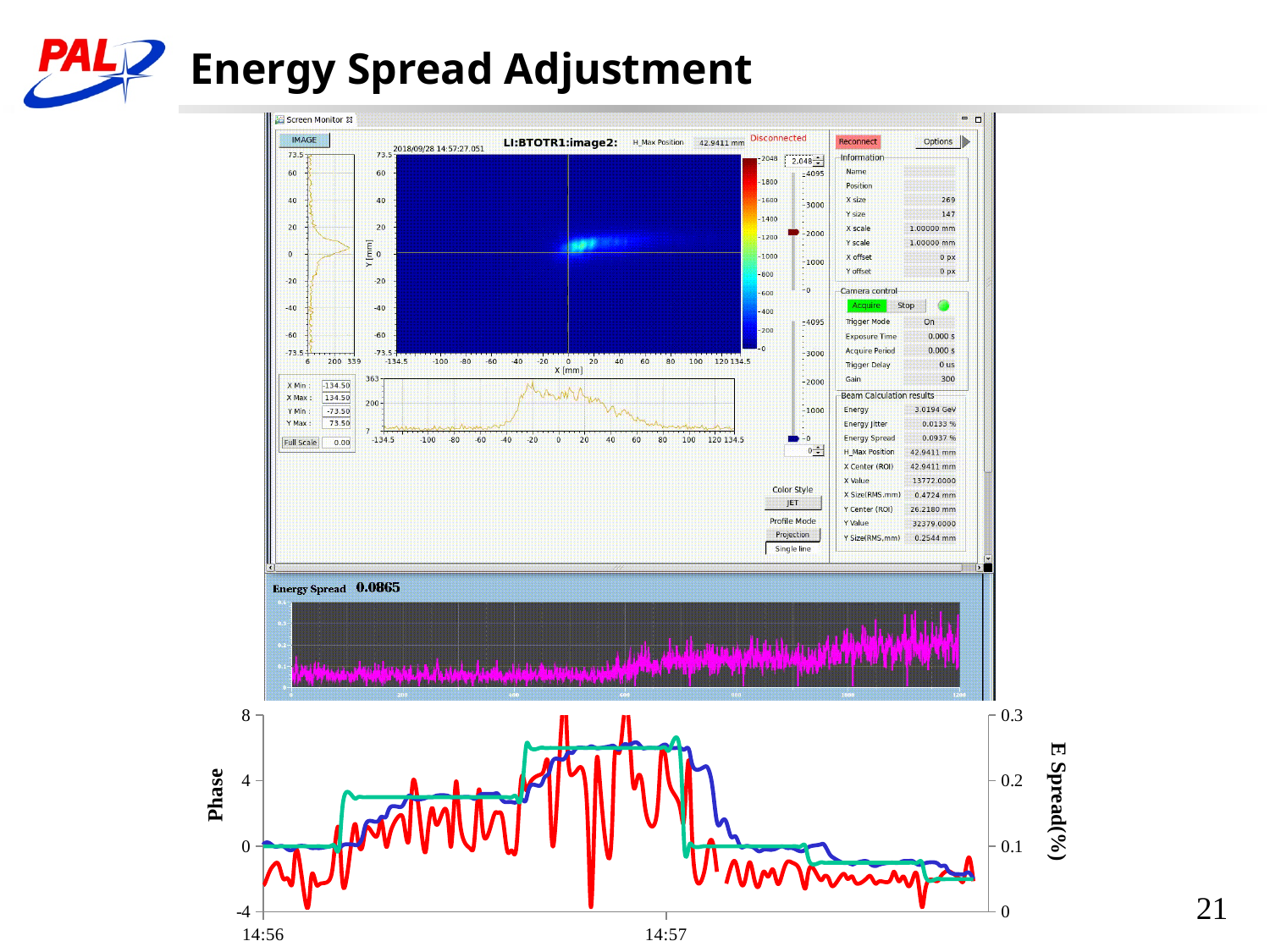
How many lines are plotted in the bottom chart? 3 In the bottom chart, what is the lowest tick value shown on the left Phase axis? -4 In the bottom chart, at 14:56 is the green line greater or less than 2 on the Phase axis? less In the bottom chart, what is the highest tick value shown on the right E Spread(%) axis? 0.3 What kind of chart is the chart at the bottom of the slide? line chart In the bottom chart, what is the highest tick value shown on the left Phase axis? 8 In the bottom chart, does the green line rise or fall between 14:56 and the middle of the chart? rise In the bottom chart, what is the label of the left vertical axis? Phase In the bottom chart, what is the label of the right vertical axis? E Spread(%) In the bottom chart, what are the two time labels shown on the x axis? 14:56 and 14:57